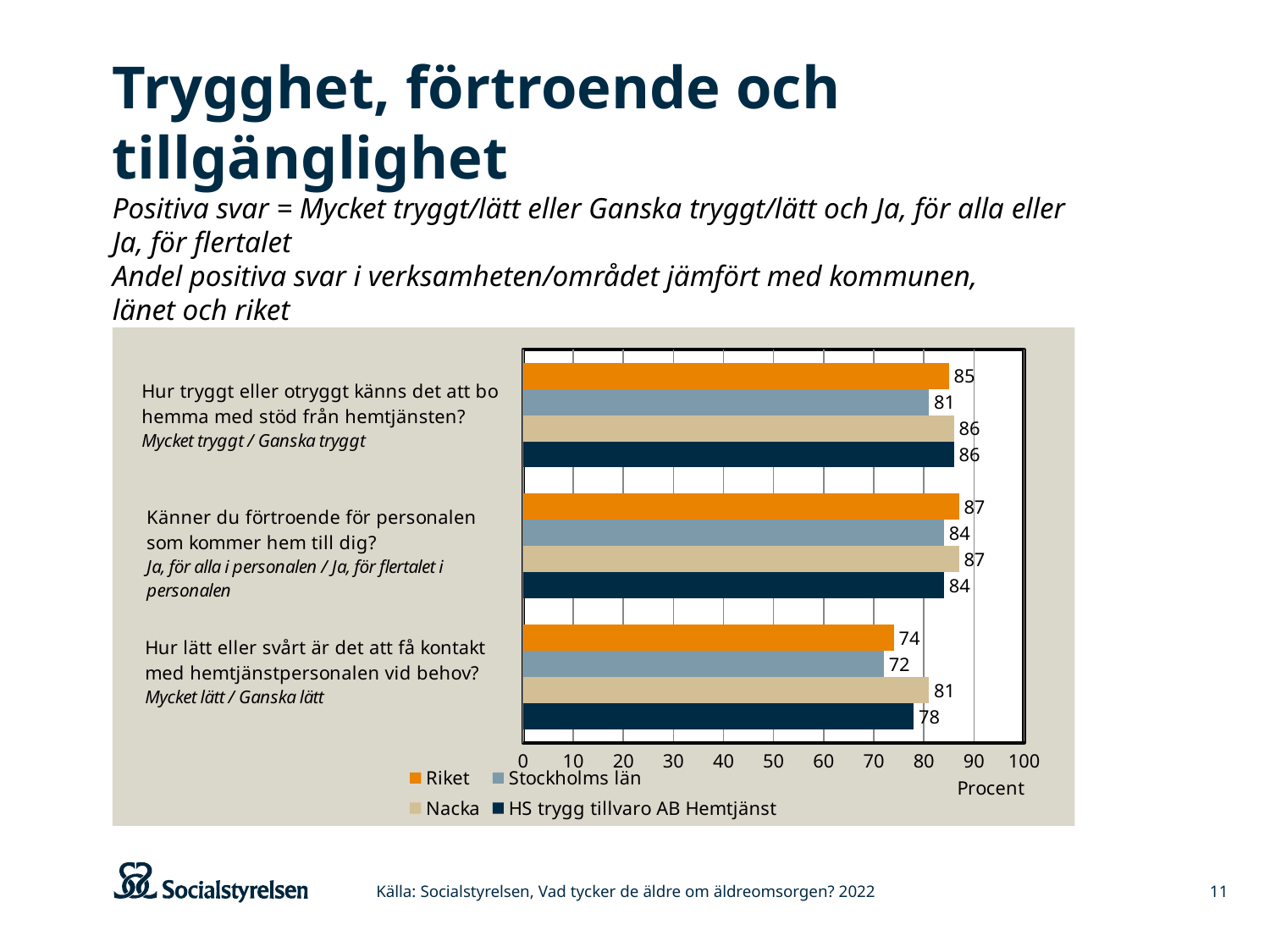
What is the value for Stockholms län on the question "Känner du förtroende för personalen som kommer hem till dig?"? 84 Which is larger for HS trygg tillvaro AB Hemtjänst: the value for "Hur tryggt eller otryggt känns det att bo hemma med stöd från hemtjänsten?" or for "Känner du förtroende för personalen som kommer hem till dig?"? Hur tryggt eller otryggt känns det att bo hemma med stöd från hemtjänsten? How many series does the legend list? 4 Which series has the lowest value on the question "Hur lätt eller svårt är det att få kontakt med hemtjänstpersonalen vid behov?"? Stockholms län What is the difference between Nacka and Riket on the question "Hur lätt eller svårt är det att få kontakt med hemtjänstpersonalen vid behov?"? 7 How many questions (categories) are plotted in the chart? 3 Is the value for Riket on the question "Hur lätt eller svårt är det att få kontakt med hemtjänstpersonalen vid behov?" greater or less than 80? less What is the value for Riket on the question "Hur tryggt eller otryggt känns det att bo hemma med stöd från hemtjänsten?"? 85 What is the value for HS trygg tillvaro AB Hemtjänst on the question "Hur lätt eller svårt är det att få kontakt med hemtjänstpersonalen vid behov?"? 78 What kind of chart is shown on the slide? Bar chart What is the value for Nacka on the question "Hur lätt eller svårt är det att få kontakt med hemtjänstpersonalen vid behov?"? 81 What unit is shown on the x axis of the chart? Procent